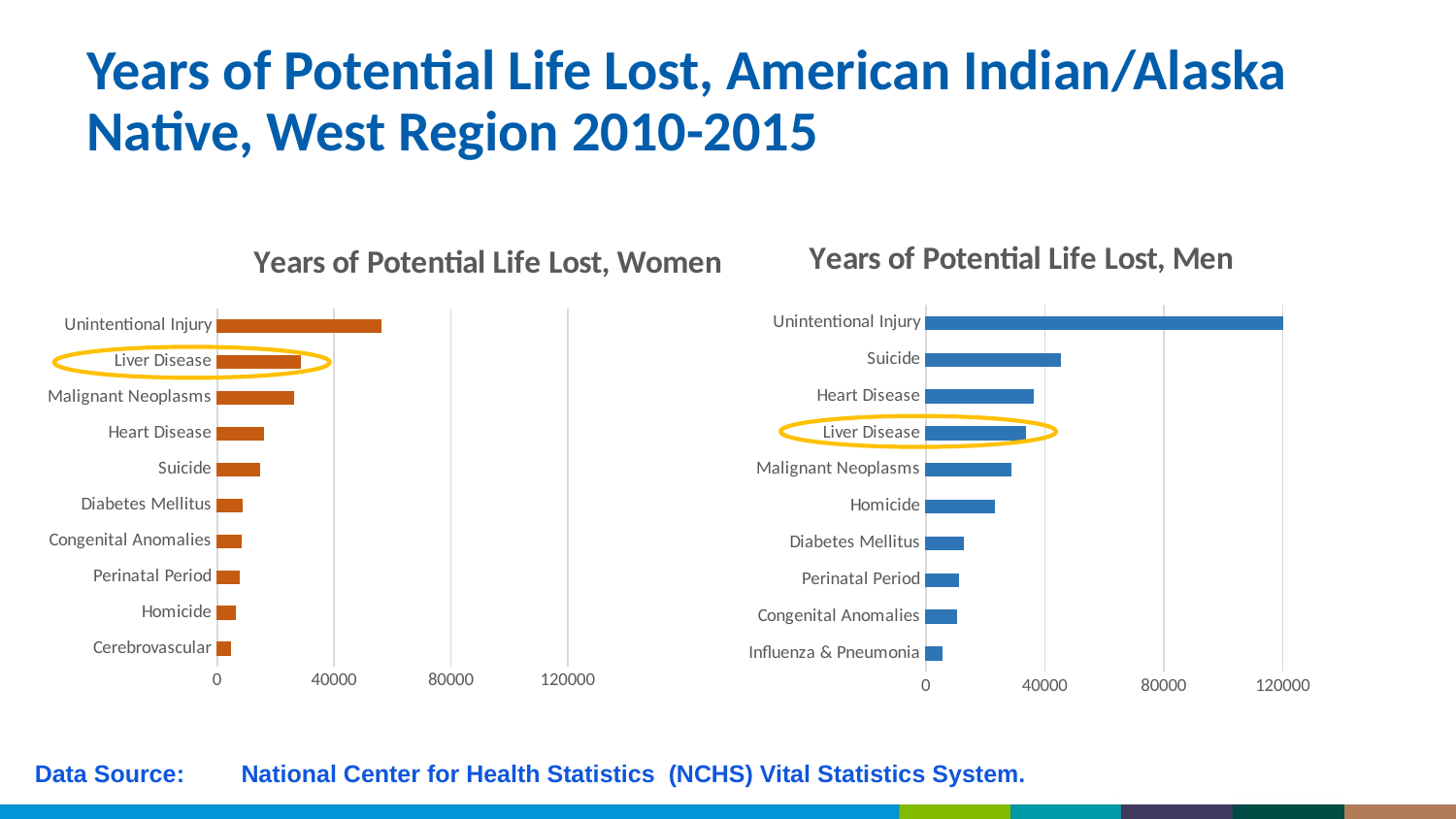
In the 'Years of Potential Life Lost, Men' chart, which cause has the lowest value? Influenza & Pneumonia In the 'Years of Potential Life Lost, Women' chart, which cause has the highest value? Unintentional Injury In the 'Years of Potential Life Lost, Women' chart, which cause has the lowest value? Cerebrovascular In the 'Years of Potential Life Lost, Men' chart, is the value for Unintentional Injury greater or less than 80000? greater How many causes are shown in the 'Years of Potential Life Lost, Men' chart? 10 In the 'Years of Potential Life Lost, Women' chart, is the value for Liver Disease greater or less than 40000? less In the 'Years of Potential Life Lost, Men' chart, which is larger: Suicide or Homicide? Suicide In the 'Years of Potential Life Lost, Women' chart, is the value for Unintentional Injury greater or less than 40000? greater In the 'Years of Potential Life Lost, Men' chart, which cause has the highest value? Unintentional Injury In the 'Years of Potential Life Lost, Women' chart, which is larger: Liver Disease or Heart Disease? Liver Disease What type of chart is the 'Years of Potential Life Lost, Women' chart? Bar chart